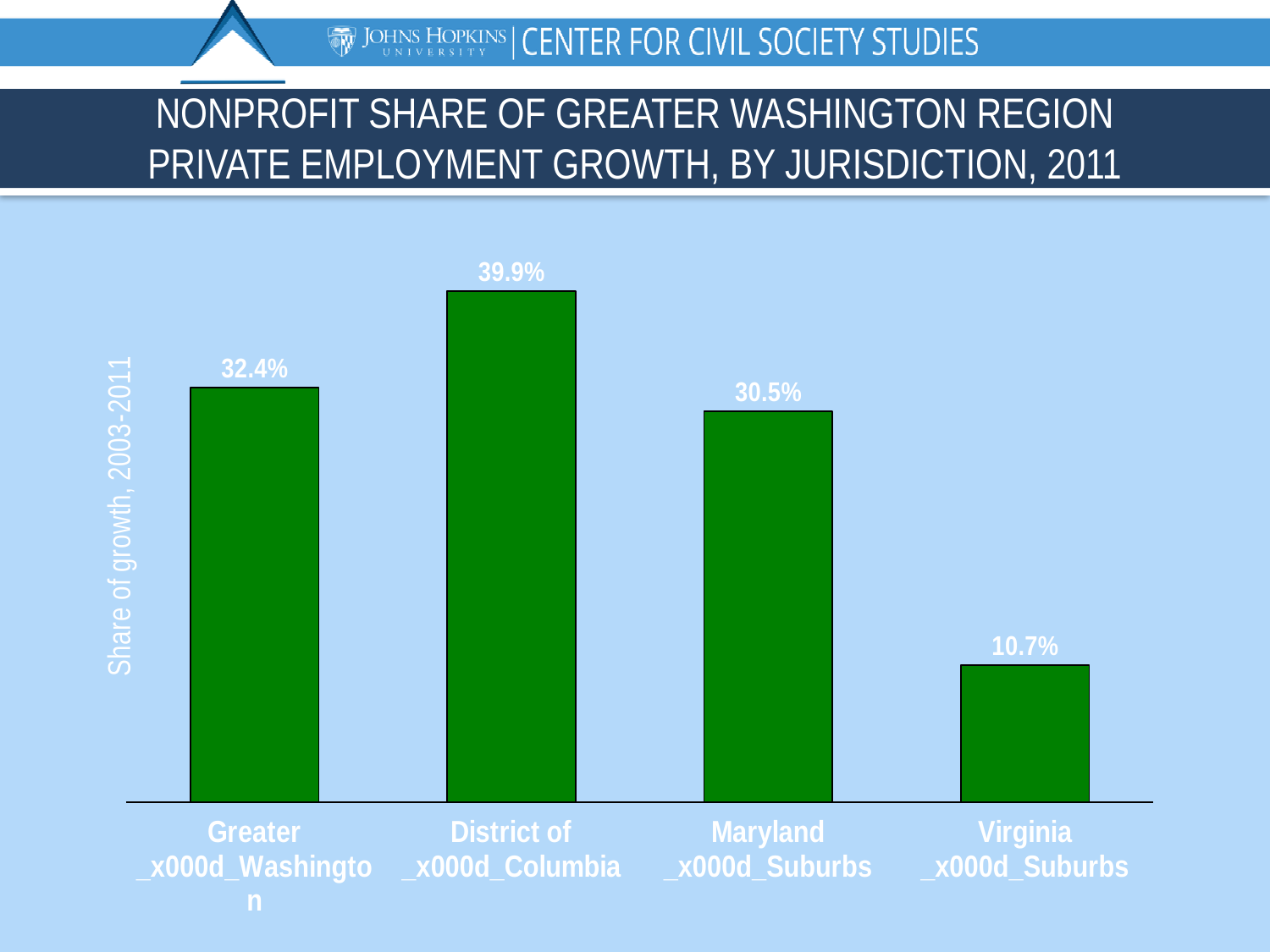
Which has a larger nonprofit share of private employment growth, the Maryland Suburbs or the Virginia Suburbs? Maryland Suburbs How many percentage points higher is the District of Columbia's share than Greater Washington's? 7.5 percentage points What is the nonprofit share of private employment growth for the Virginia Suburbs? 10.7% What is the nonprofit share of private employment growth for the Maryland Suburbs? 30.5% How many jurisdictions are shown in the chart? 4 What type of chart is shown on the slide? Bar chart Which jurisdiction has the highest nonprofit share of private employment growth? District of Columbia What is the nonprofit share of private employment growth for the District of Columbia? 39.9% Which jurisdiction has the lowest nonprofit share of private employment growth? Virginia Suburbs What is the label on the vertical axis of the chart? Share of growth, 2003-2011 What is the difference between the Maryland Suburbs' share and the Virginia Suburbs' share? 19.8 percentage points What is the nonprofit share of private employment growth for Greater Washington? 32.4%